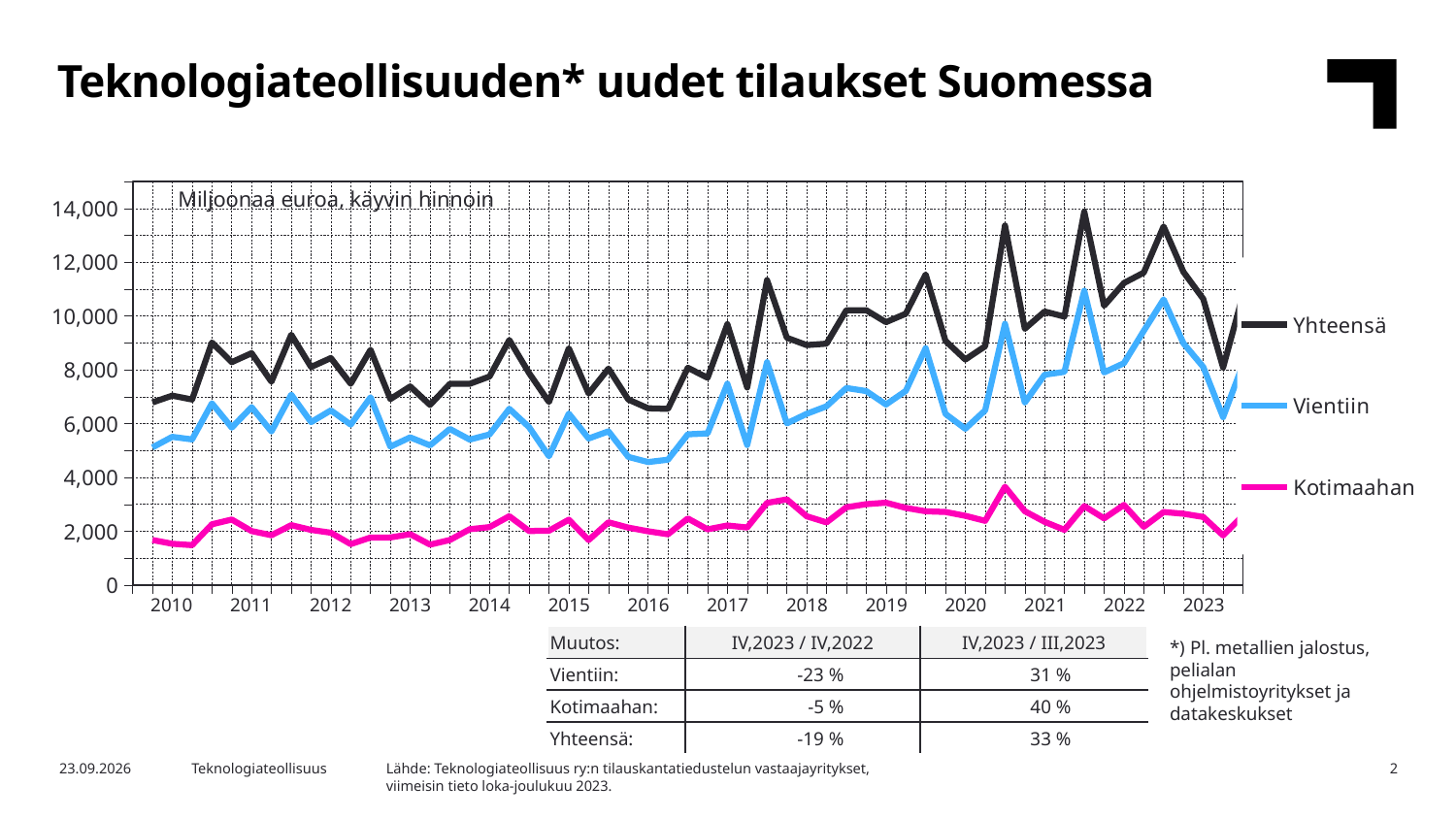
Is the value for Kotimaahan at the start of 2010 greater or less than 2,000? less Which series is larger in 2019, Vientiin or Kotimaahan? Vientiin What unit is stated at the top of the chart? Miljoonaa euroa, käyvin hinnoin How many series does the legend list? 3 Does the Yhteensä series generally rise or fall from 2016 to 2021? rise Is the peak value of Yhteensä in 2021 greater or less than 12,000? greater Which series has the lowest values throughout the chart? Kotimaahan How many years are labelled on the x axis? 14 Which series are listed in the chart legend? Yhteensä, Vientiin, Kotimaahan Which series has the highest values throughout the chart? Yhteensä What kind of chart is shown on the slide? line chart Is the lowest value for Vientiin in 2016 greater or less than 6,000? less